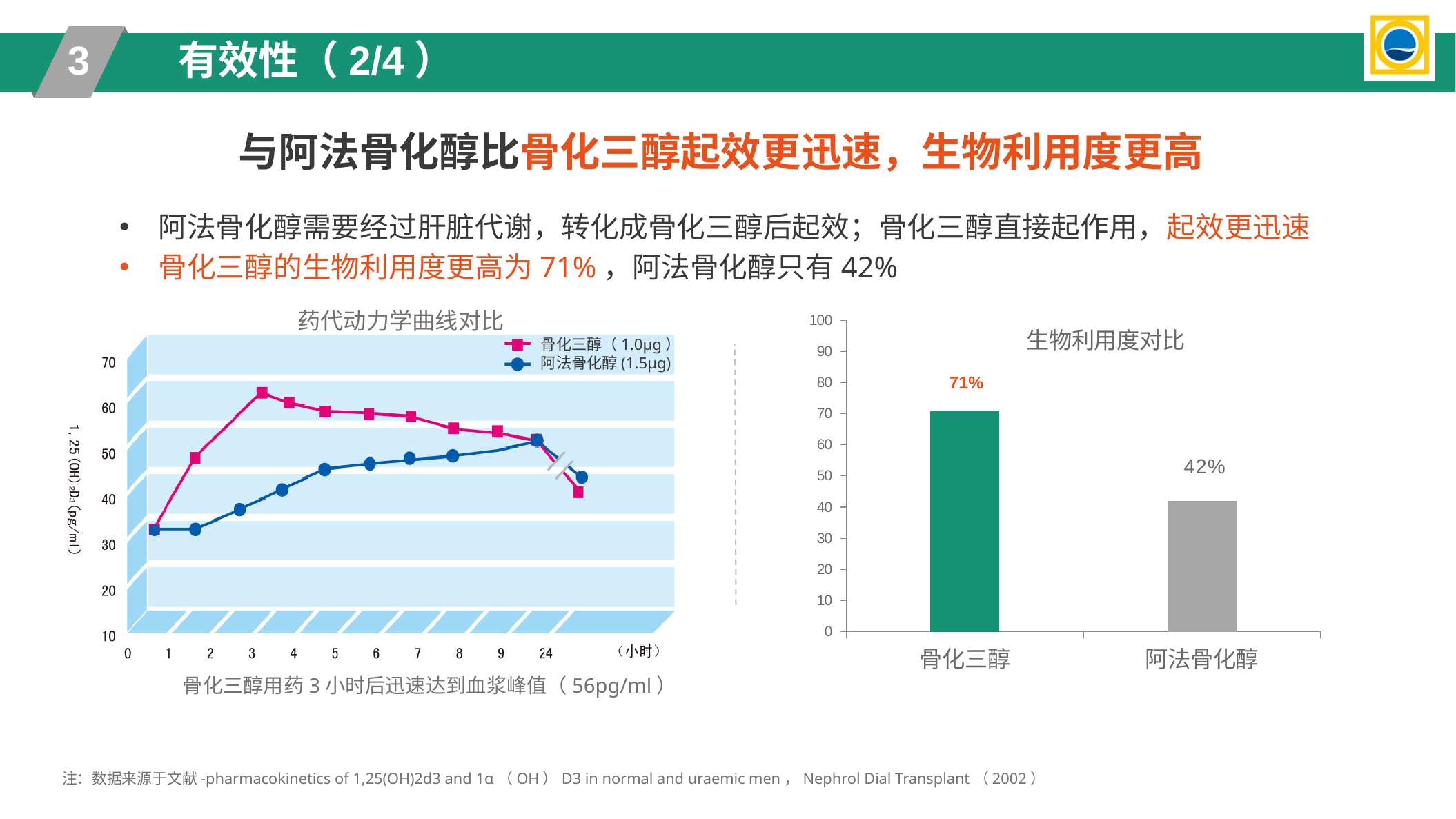
In the 生物利用度对比 chart, what is the value for 骨化三醇? 71% What kind of chart is the 药代动力学曲线对比 chart? Line chart In the 生物利用度对比 chart, what is the value for 阿法骨化醇? 42% What kind of chart is the 生物利用度对比 chart? Bar chart In the 生物利用度对比 chart, how many categories are shown? 2 In the 药代动力学曲线对比 chart, how many series does the legend list? 2 In the 生物利用度对比 chart, which category has the higher value? 骨化三醇 In the 药代动力学曲线对比 chart, is the value for 骨化三醇（1.0μg） at hour 3 greater or less than 50? greater In the 药代动力学曲线对比 chart, is the value for 阿法骨化醇 (1.5μg) at hour 1 greater or less than 40? less In the 药代动力学曲线对比 chart, which series reaches the higher value at hour 3? 骨化三醇（1.0μg） In the 生物利用度对比 chart, what is the difference between the values for 骨化三醇 and 阿法骨化醇? 29% In the 药代动力学曲线对比 chart, does the 阿法骨化醇 (1.5μg) series rise or fall from hour 1 to hour 9? Rise